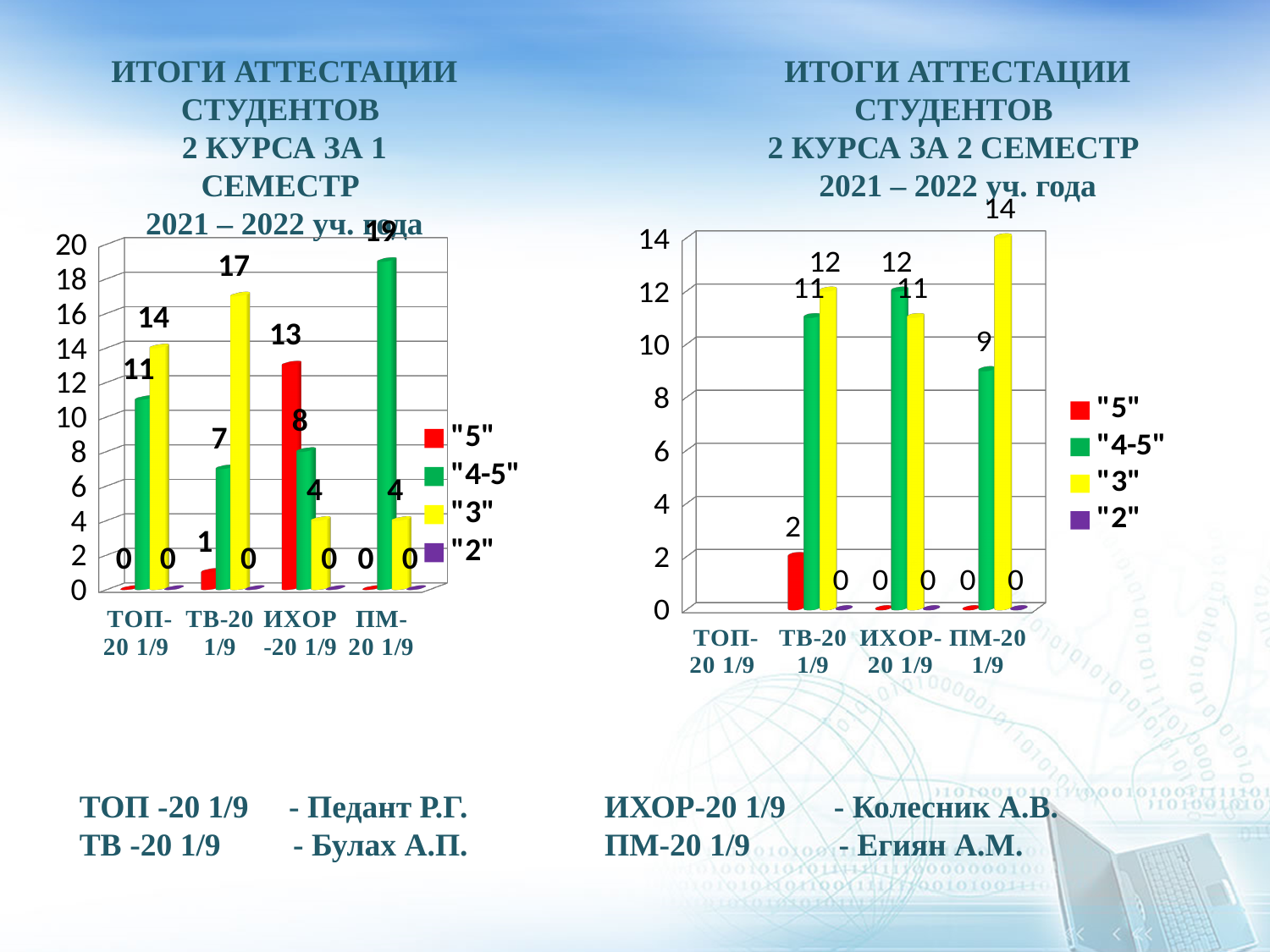
In the left chart (1 семестр), what is the value of the "5" series for ИХОР-20 1/9? 13 In the left chart (1 семестр), what is the value of the "2" series for ТВ-20 1/9? 0 How many groups are shown on the x axis of the right chart (2 семестр)? 4 In the left chart (1 семестр), for ИХОР-20 1/9, which is larger: the "4-5" value or the "3" value? "4-5" In the left chart (1 семестр), what is the value of the "4-5" series for ПМ-20 1/9? 19 What type of chart is the left chart (1 семестр)? bar chart In the left chart (1 семестр), which group has the highest value for the "4-5" series? ПМ-20 1/9 In the right chart (2 семестр), which series has the tallest bar? "3" In the right chart (2 семестр), what is the highest value labeled on any bar? 14 In the left chart (1 семестр), what is the difference between the "3" values for ТОП-20 1/9 and ИХОР-20 1/9? 10 How many series does the legend of the left chart (1 семестр) list? 4 In the left chart (1 семестр), what is the value of the "3" series for ТВ-20 1/9? 17